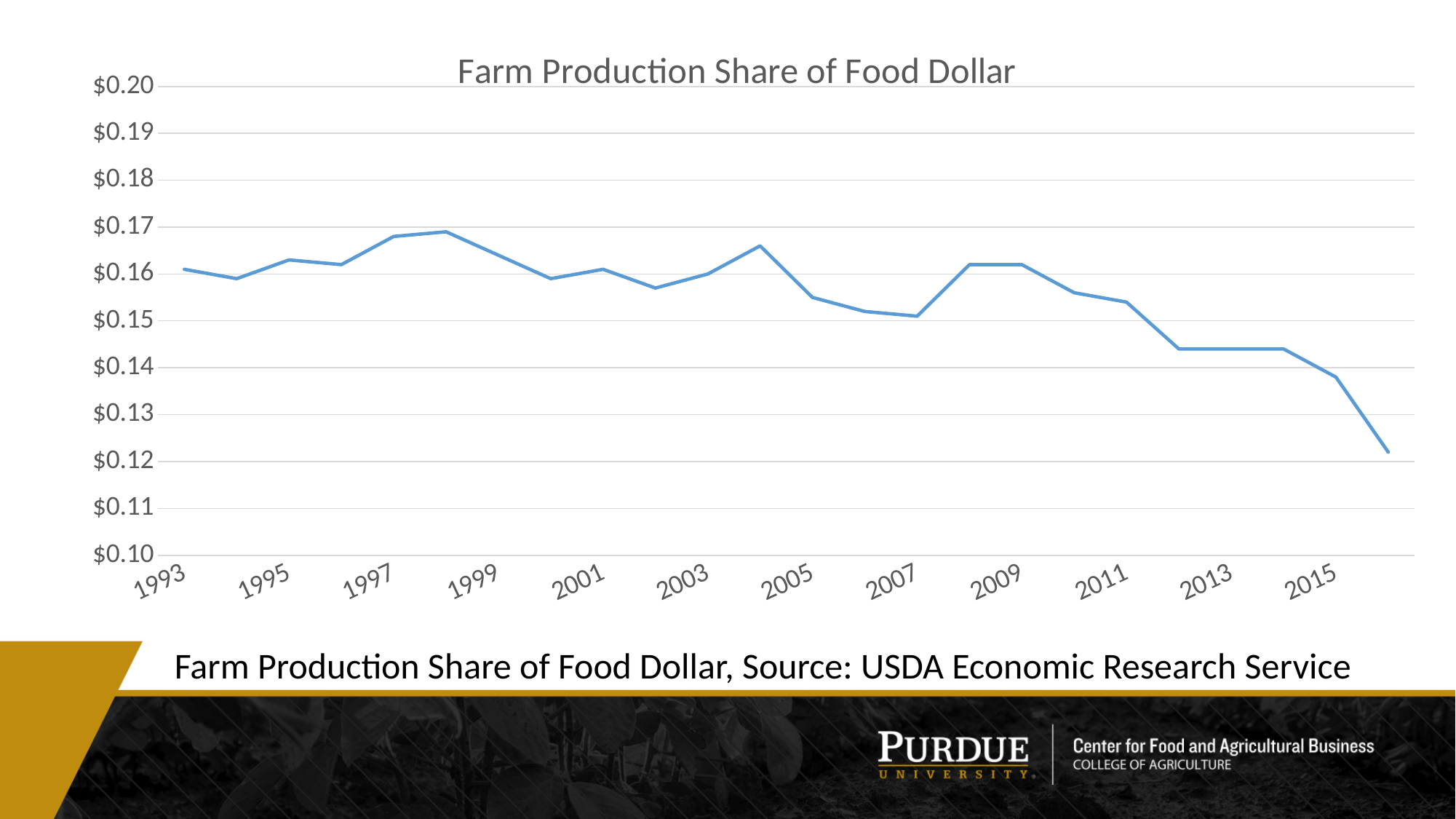
Is the value for 2004 greater or less than $0.16? greater Is the value for 2015 greater or less than $0.14? less How many year labels are shown on the x axis? 12 Overall, does the farm production share of the food dollar rise or fall from 1993 to 2016? fall What kind of chart is shown on the slide? line chart What is the title of the chart? Farm Production Share of Food Dollar Which year has the lowest farm production share of the food dollar? 2016 Which is larger, the value for 2004 or the value for 2006? 2004 Is the value for 2012 greater or less than $0.15? less Which is larger, the value for 1993 or the value for 2016? 1993